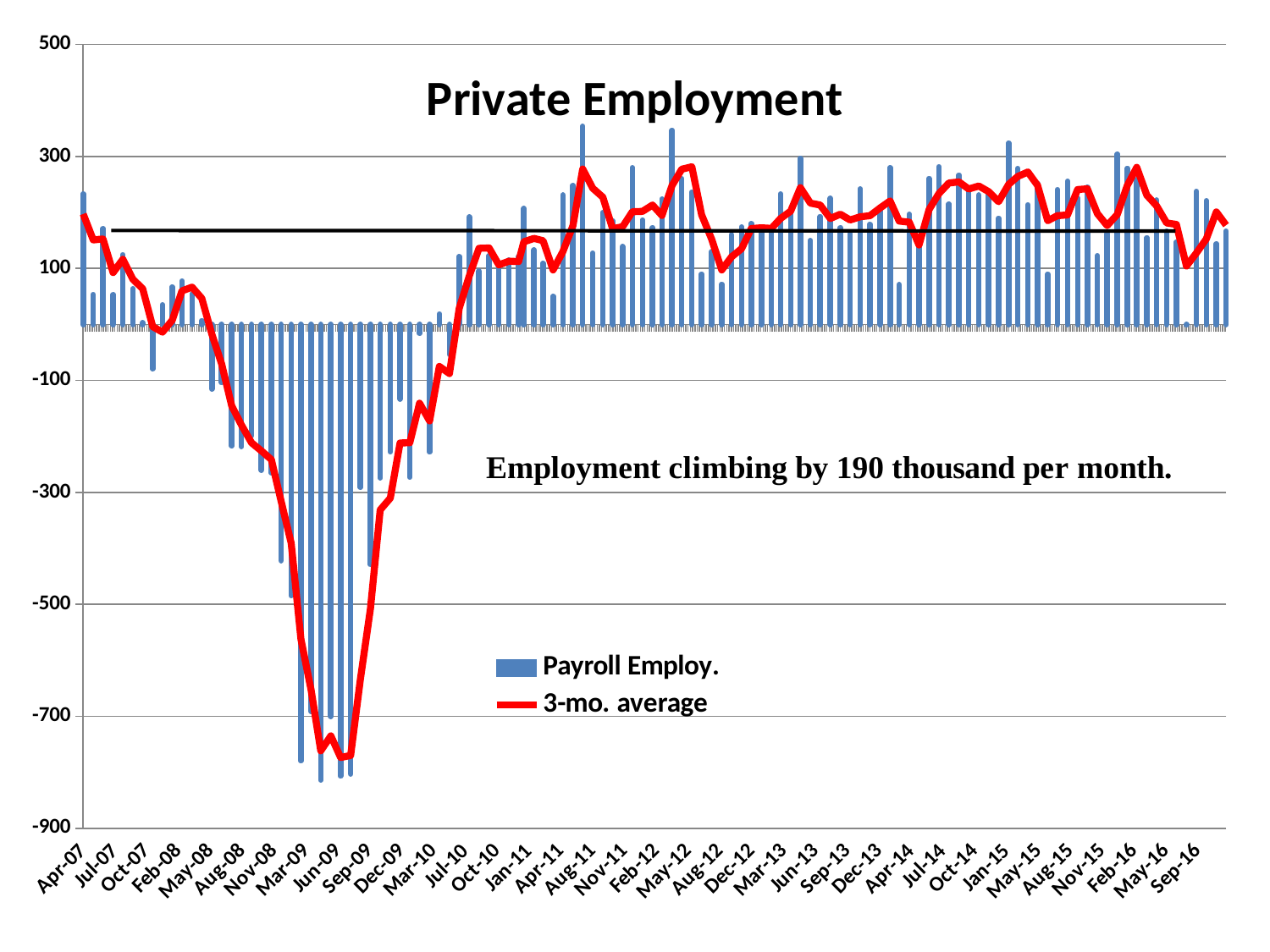
What does the text annotation on the chart say? Employment climbing by 190 thousand per month. Which series is drawn as a red line? 3-mo. average Is the 3-mo. average value at Jun-09 greater or less than -500? less Is the 3-mo. average value at Feb-12 greater or less than 100? greater How many labels are shown on the x axis? 36 Which has the larger Payroll Employ. value, Mar-09 or Dec-09? Dec-09 Is the Payroll Employ. value at Mar-09 greater or less than -500? less How many series does the legend list? 2 What kind of chart is shown on the slide? A combined bar and line chart Do the Payroll Employ. values generally rise or fall from Apr-07 to Mar-09? fall What is the title of the chart? Private Employment